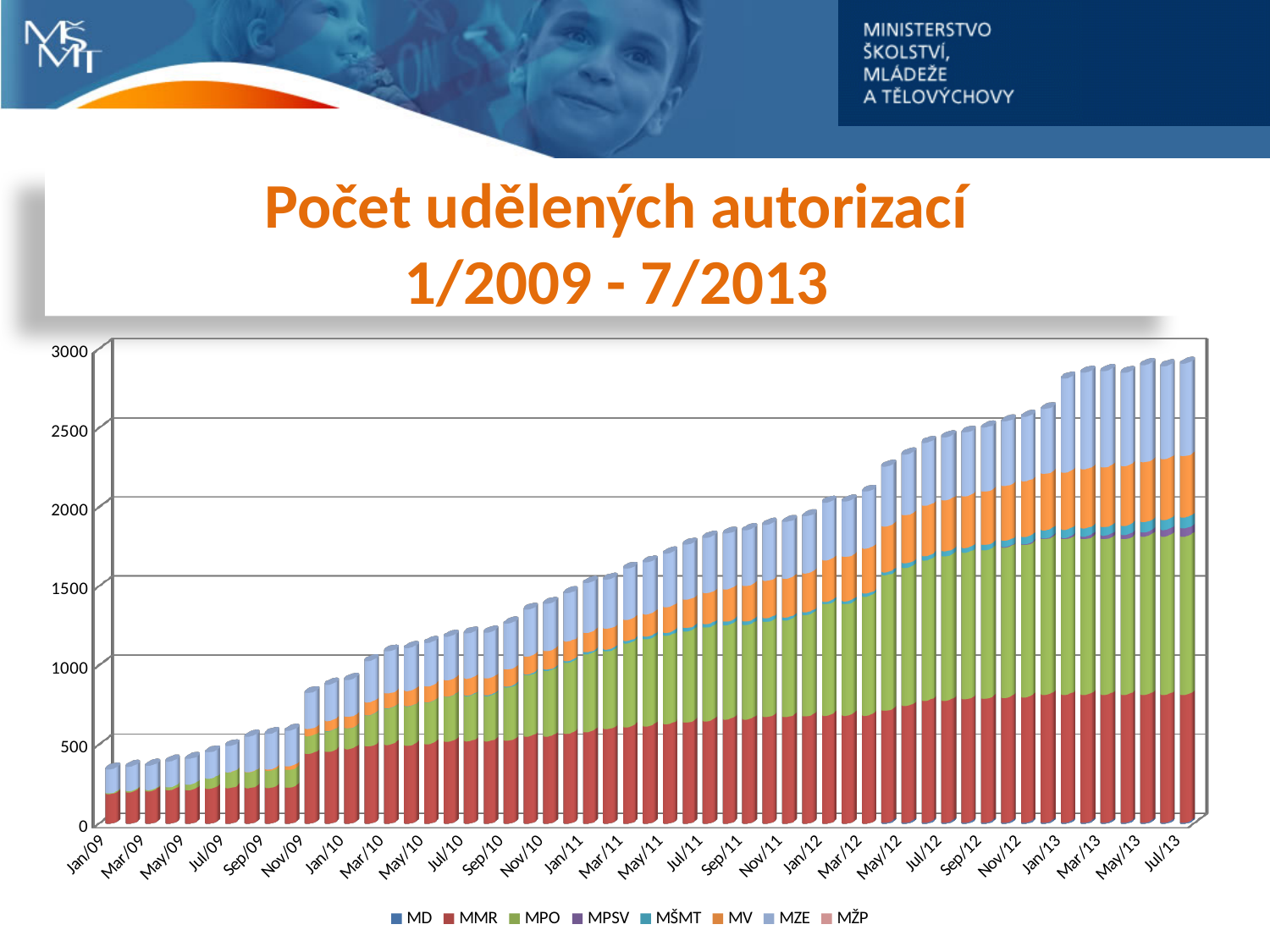
Is the total for Jan/13 greater or less than 2500? greater Do the total bar heights rise or fall from Jan/09 to Jul/13? rise Which has the larger total bar, Jan/09 or Jul/13? Jul/13 Which series is shown in red in the legend? MMR Is the total for Jan/10 greater or less than 1000? less How many series does the legend list? 8 Which month has the lowest total bar? Jan/09 Is the total for Jul/11 greater or less than 1500? greater Which has the larger total bar, Jan/10 or Jan/11? Jan/11 What is the title of the chart? Počet udělených autorizací 1/2009 - 7/2013 What kind of chart is shown on the slide? stacked bar chart